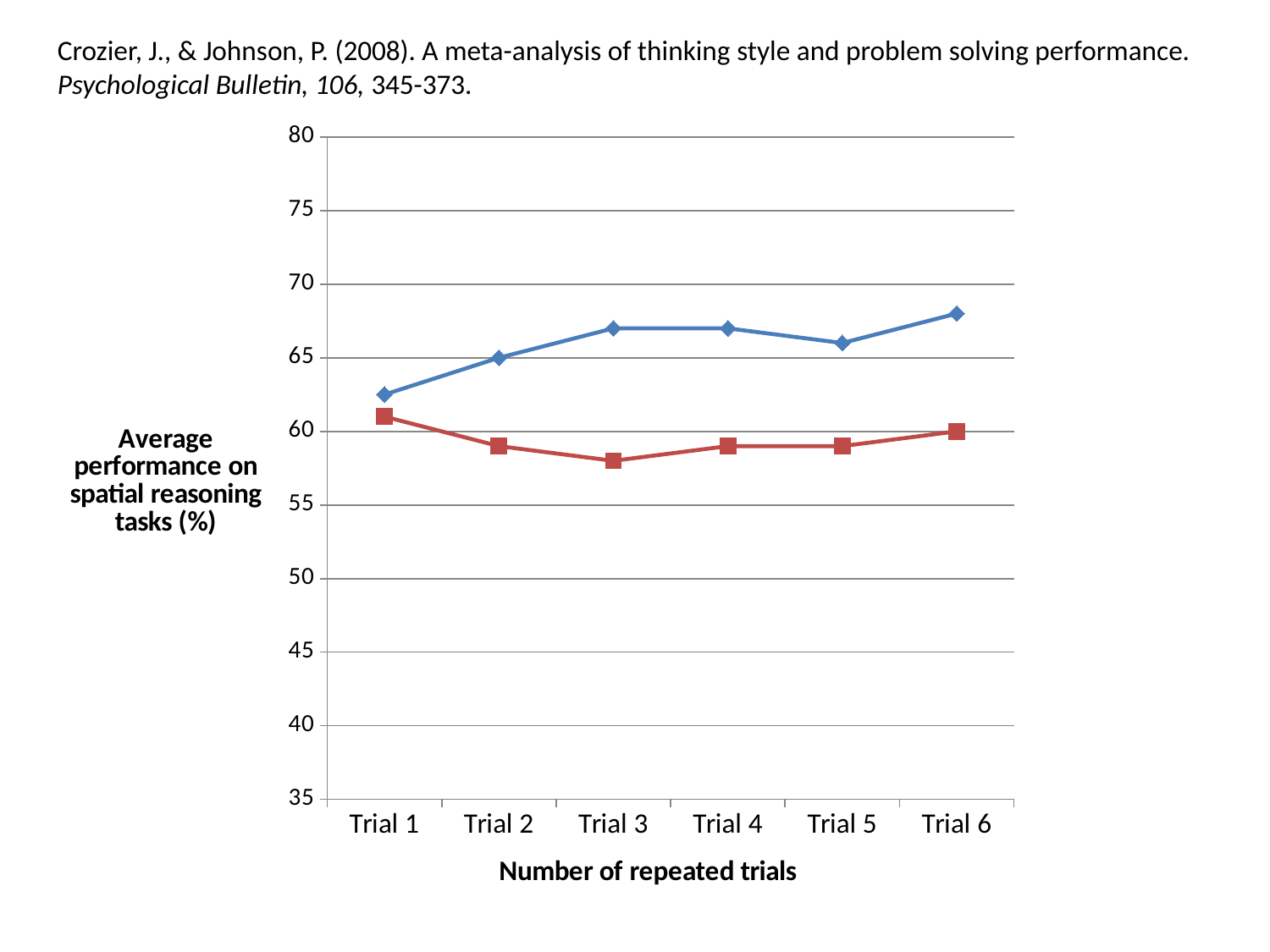
What is the title of the y axis? Average performance on spatial reasoning tasks (%) What kind of chart is shown on the slide? line chart At Trial 3, which line has the higher value, the blue line or the red line? the blue line Is the value of the blue line at Trial 6 greater or less than 65? greater Is the value of the red line at Trial 3 greater or less than 60? less What is the title of the x axis? Number of repeated trials Does the blue line rise or fall overall from Trial 1 to Trial 6? rise What is the value of the red line at Trial 6? 60 At which trial does the blue line reach its highest value? Trial 6 At which trial does the red line reach its lowest value? Trial 3 What is the value of the blue line at Trial 2? 65 How many trials are shown along the x axis? 6